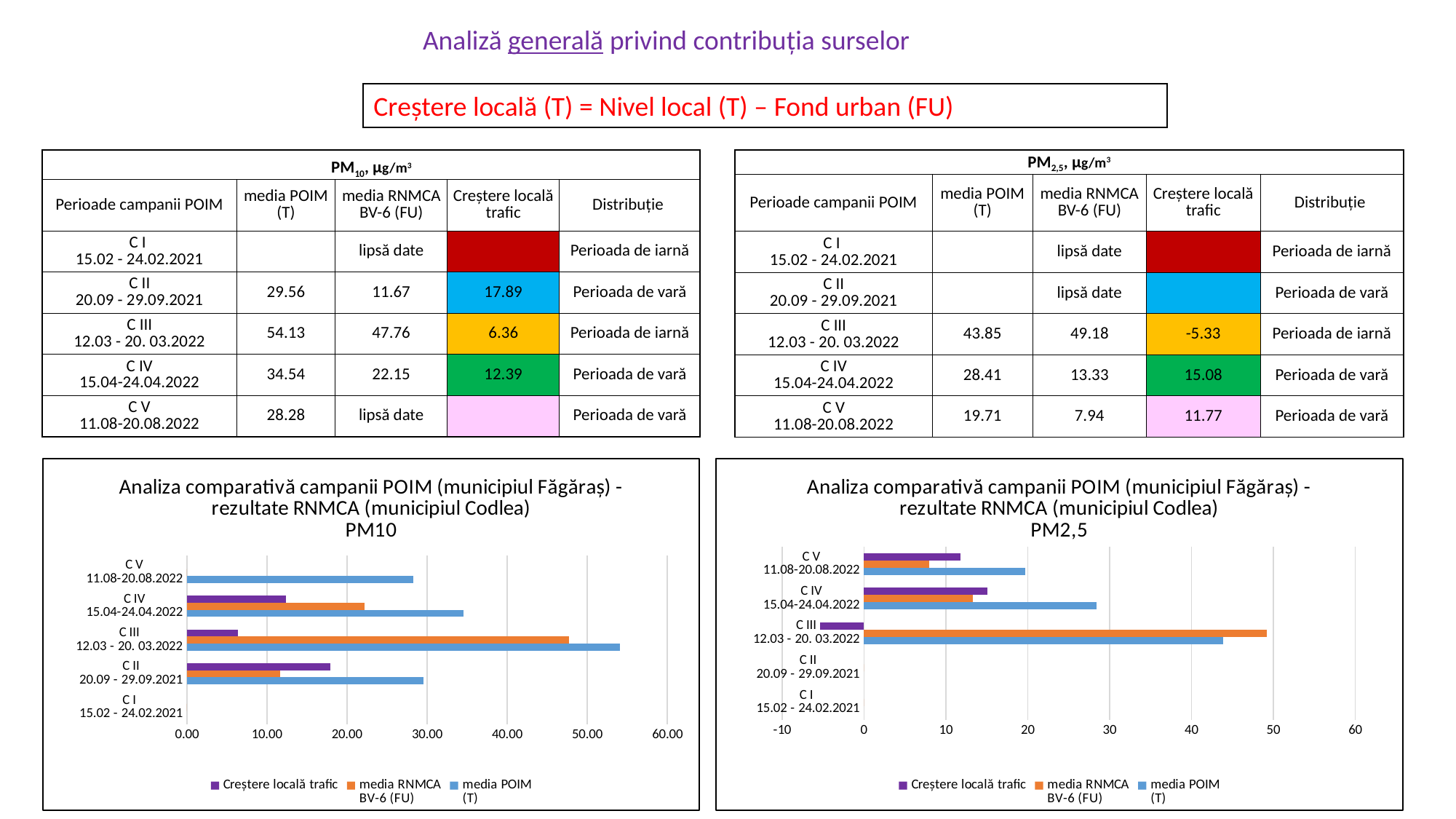
How many campaign categories are shown on the y axis of the PM10 chart on the left? 5 In the PM2,5 chart on the right, which campaign has a negative Creștere locală trafic value? C III 12.03 - 20. 03.2022 In the PM10 chart on the left, for C IV, which is larger: media POIM (T) or media RNMCA BV-6 (FU)? media POIM (T) How many series does the legend of the PM2,5 chart on the right list? 3 In the PM2,5 chart on the right, what colour represents the Creștere locală trafic series? purple In the PM10 chart on the left, what is the Creștere locală trafic value for C II (20.09 - 29.09.2021)? 17.89 In the PM2,5 chart on the right, is the media RNMCA BV-6 (FU) value for C III greater or less than 40? greater In the PM10 chart on the left, which campaign has the highest media POIM (T) value? C III 12.03 - 20. 03.2022 In the PM10 chart on the left, is the media POIM (T) value for C III greater or less than 50.00? greater What kind of chart is the PM10 chart on the left? bar chart In the PM2,5 chart on the right, what is the Creștere locală trafic value for C IV (15.04-24.04.2022)? 15.08 In the PM10 chart on the left, is the media RNMCA BV-6 (FU) value for C II greater or less than 20.00? less